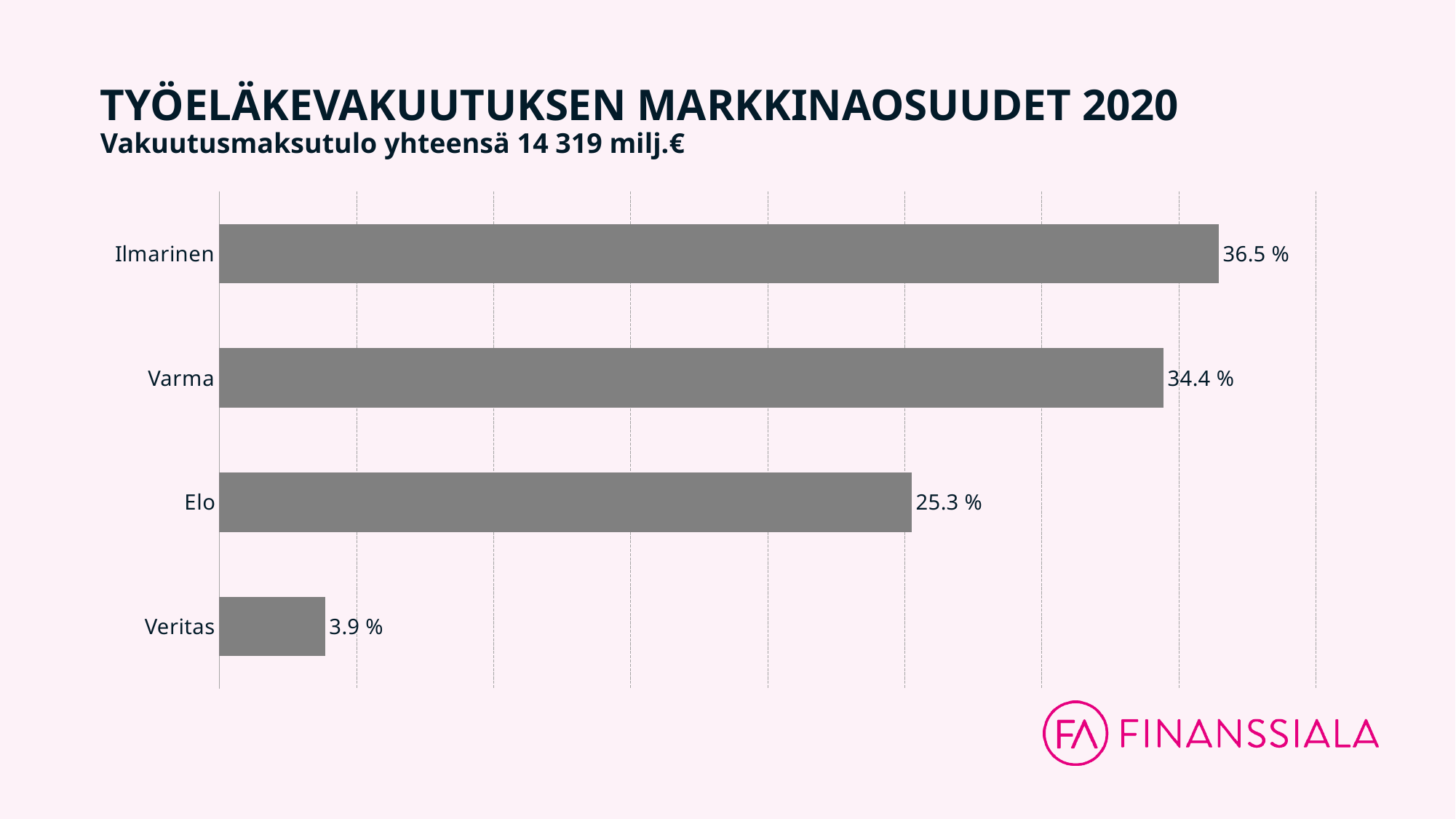
What is the market share shown for Veritas? 3.9 % What kind of chart is shown on the slide? Bar chart What is the market share shown for Varma? 34.4 % What total premium income (vakuutusmaksutulo yhteensä) is stated in the subtitle? 14 319 milj.€ Which has a larger market share, Varma or Elo? Varma What is the difference in percentage points between Elo's and Veritas's market shares? 21.4 Which company has the lowest market share? Veritas What is the market share shown for Elo? 25.3 % What is the difference in percentage points between Ilmarinen's and Varma's market shares? 2.1 Which company has the highest market share? Ilmarinen What is the market share shown for Ilmarinen? 36.5 % How many companies are shown in the chart? 4